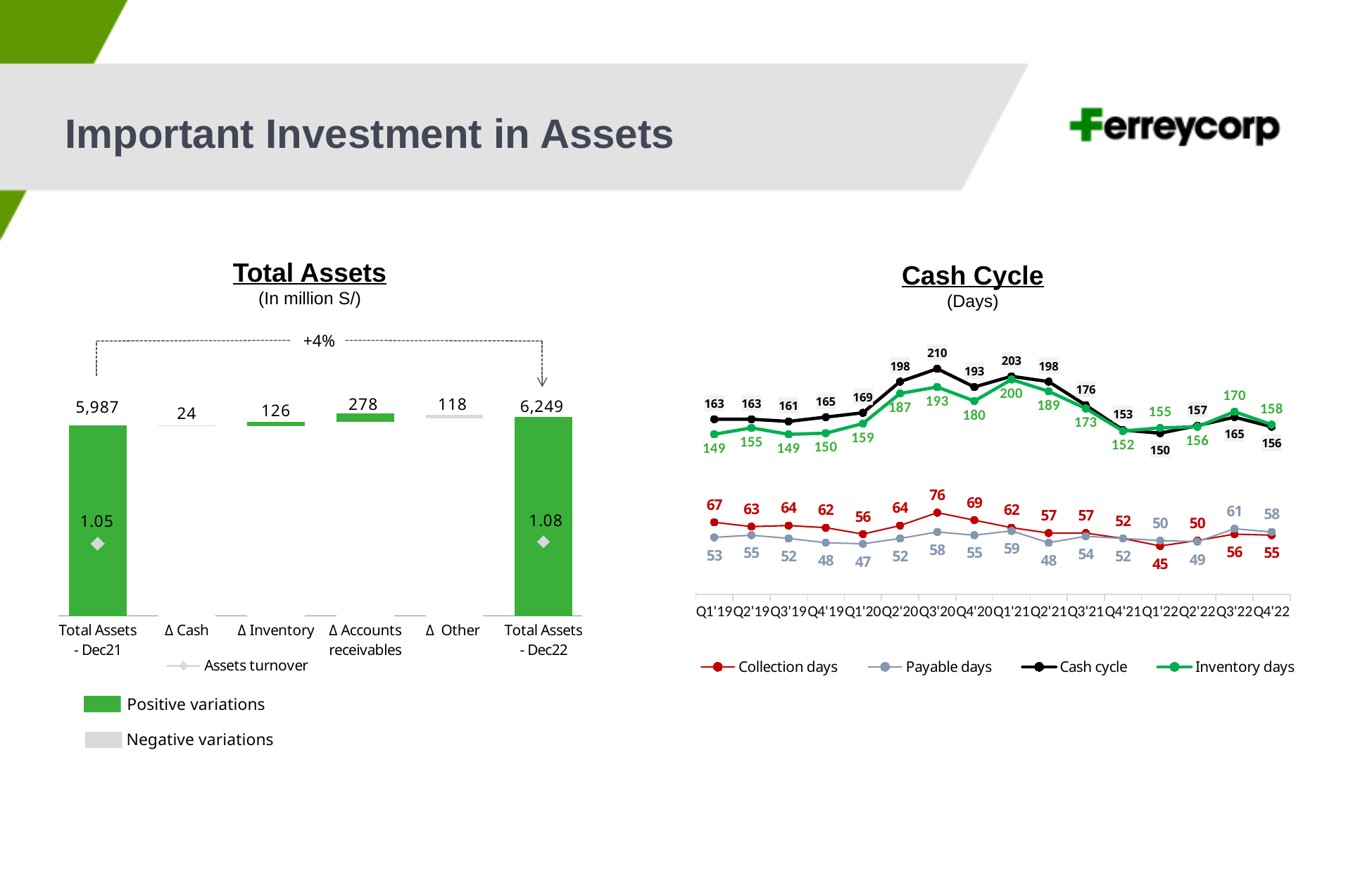
In the Cash Cycle chart, what is the Cash cycle value for Q3'20? 210 In the Total Assets chart, what is the Assets turnover value shown for Total Assets - Dec22? 1.08 What kind of chart is the Cash Cycle chart? Line chart In the Total Assets chart, what is the value for Total Assets - Dec22? 6,249 In the Total Assets chart, what is the difference between Total Assets - Dec22 and Total Assets - Dec21? 262 In the Total Assets chart, which category is shown as a negative variation? Δ Other How many series does the legend of the Cash Cycle chart list? 4 In the Cash Cycle chart, which is larger: Inventory days in Q1'21 or in Q4'22? Q1'21 In the Cash Cycle chart, what is the Payable days value for Q3'22? 61 In the Total Assets chart, what is the value for Δ Accounts receivables? 278 In the Cash Cycle chart, in which quarter are Collection days lowest? Q1'22 In the Cash Cycle chart, in which quarter is the Cash cycle highest? Q3'20